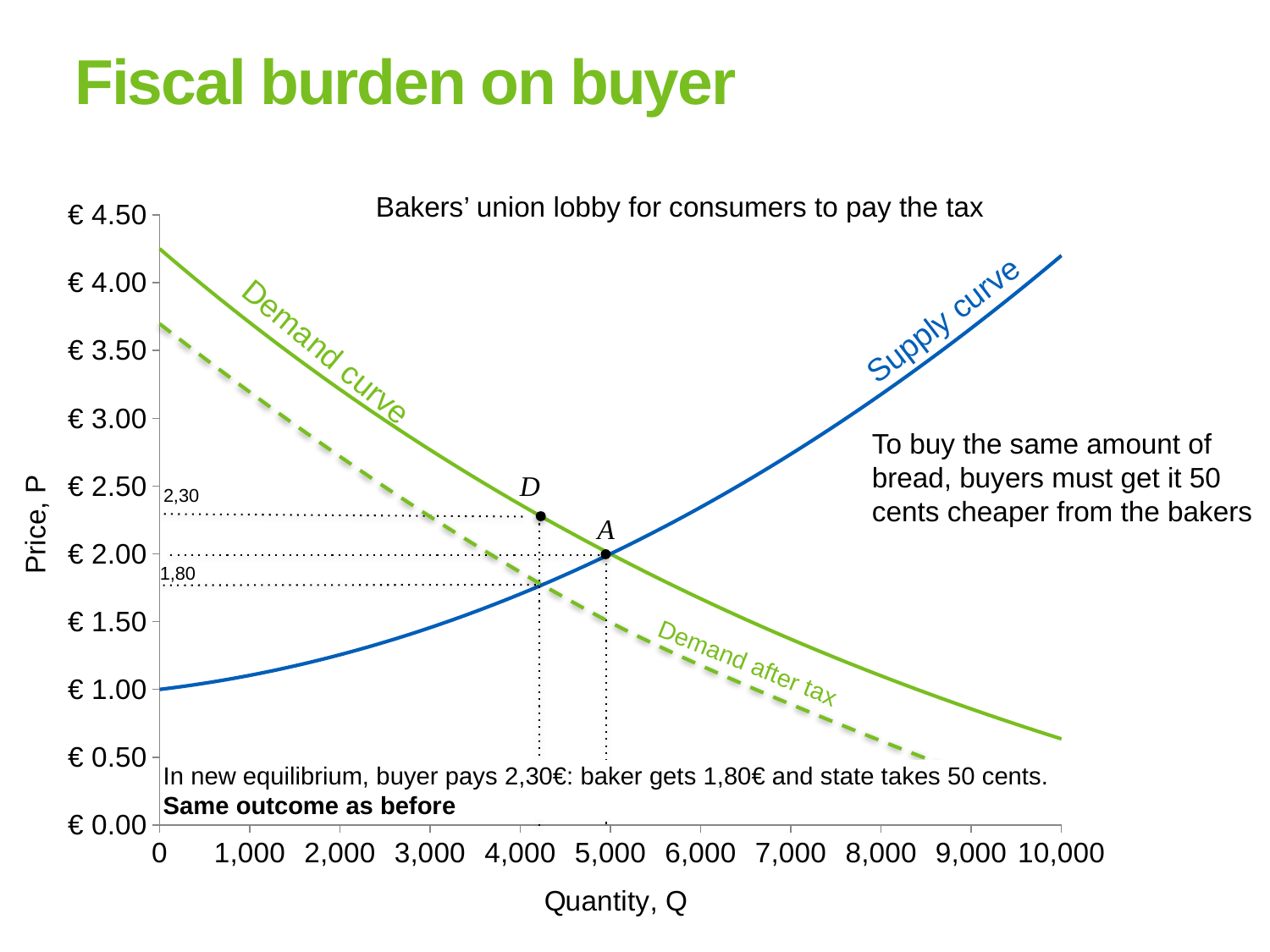
What kind of chart is shown on the slide? line chart Does the demand curve rise or fall as quantity increases along the x axis? falls What price is marked at point D on the chart? 2,30 At what quantity on the x axis does point A lie? 5,000 Does the supply curve rise or fall as quantity increases along the x axis? rises At quantity 2,000, which is higher: the demand curve or the supply curve? Demand curve Is the value of the demand curve at quantity 10,000 greater or less than € 1.00? less What is the difference between the price marked 2,30 and the price marked 1,80 on the chart? 50 cents What price does the lower dotted line on the chart mark, the price the baker receives after tax? 1,80 At what price on the y axis does point A, the intersection of the demand and supply curves, lie? € 2.00 How many curves are plotted on the chart? 3 Which curve on the chart is drawn as a dashed line? Demand after tax